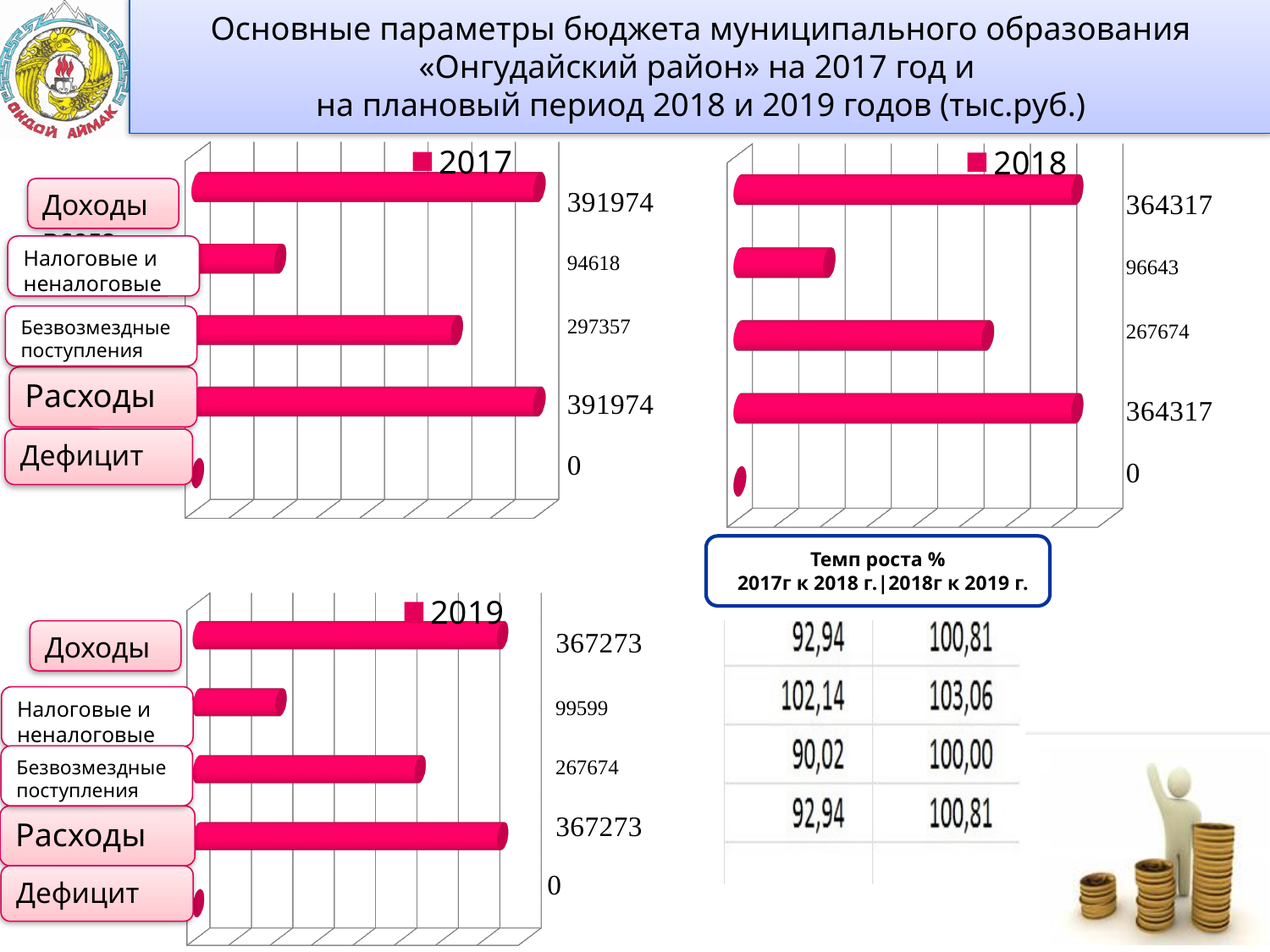
What kind of chart is the 2019 chart? Bar chart How many series does the legend of the 2017 chart list? 1 In the 2019 chart, what is the difference between Доходы and Безвозмездные поступления? 99599 In the 2019 chart, what is the value for Безвозмездные поступления? 267674 In the 2019 chart, what is the value for Расходы? 367273 In the 2018 chart, which is larger: Налоговые и неналоговые or Безвозмездные поступления? Безвозмездные поступления In the 2017 chart, which category has the lowest value? Дефицит In the 2017 chart, what is the value for Доходы? 391974 In the 2017 chart, what is the difference between Безвозмездные поступления and Налоговые и неналоговые? 202739 How many categories are plotted in the 2018 chart? 5 In the 2018 chart, what is the value for Налоговые и неналоговые? 96643 In the 2018 chart, what is the value for Дефицит? 0